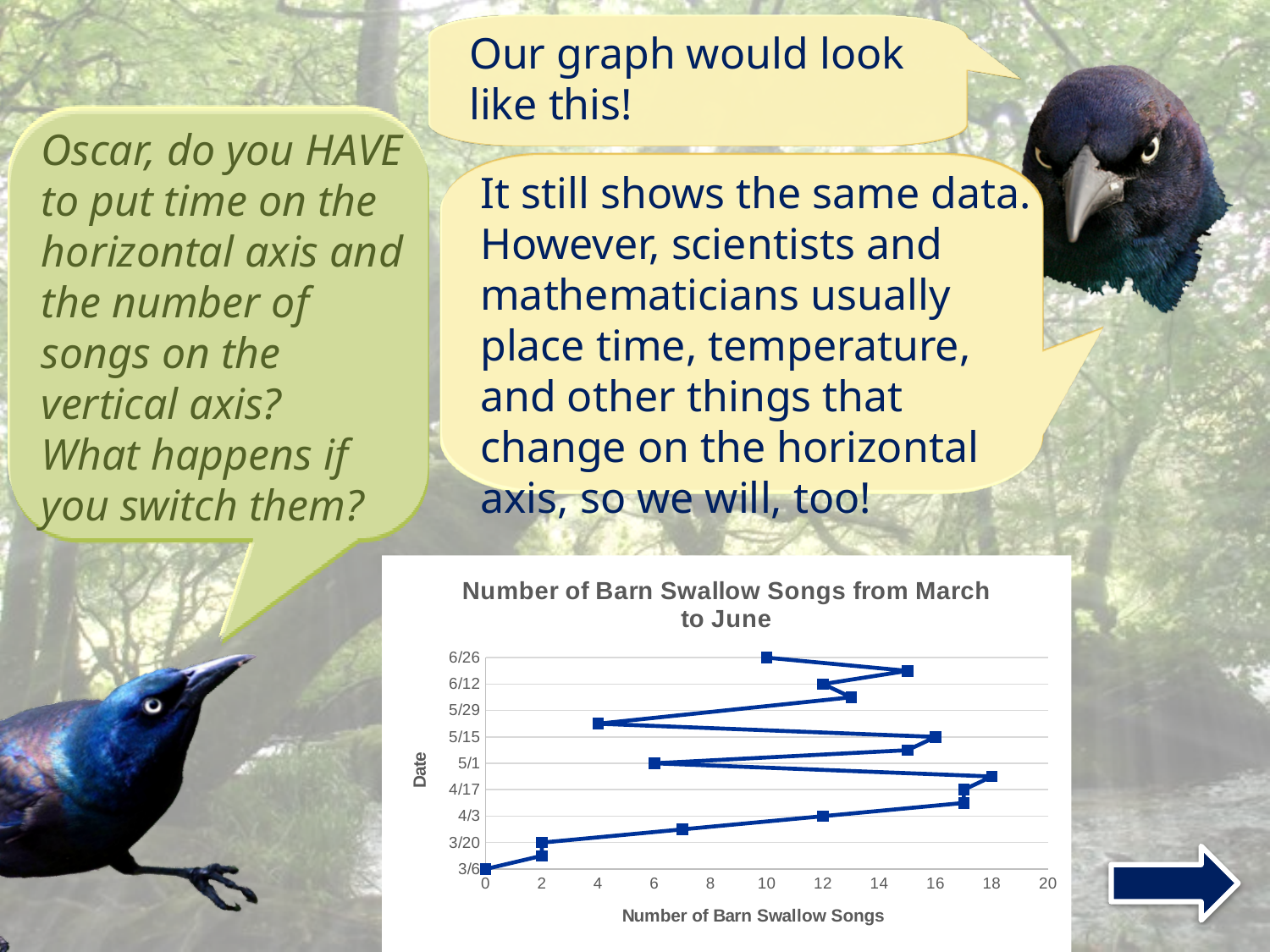
How many barn swallow songs were recorded on 6/26? 10 Which date has the lowest number of barn swallow songs? 3/6 What is the label of the horizontal axis of the chart? Number of Barn Swallow Songs How many barn swallow songs were recorded on 3/20? 2 Which date had more barn swallow songs, 4/3 or 5/1? 4/3 What kind of chart is shown on the slide? line chart What is the difference between the number of songs on 5/15 and on 5/1? 10 How many barn swallow songs were recorded on 5/15? 16 How many barn swallow songs were recorded on 4/3? 12 What is the title of the chart? Number of Barn Swallow Songs from March to June How many barn swallow songs were recorded on 5/1? 6 How many barn swallow songs were recorded on 3/6? 0